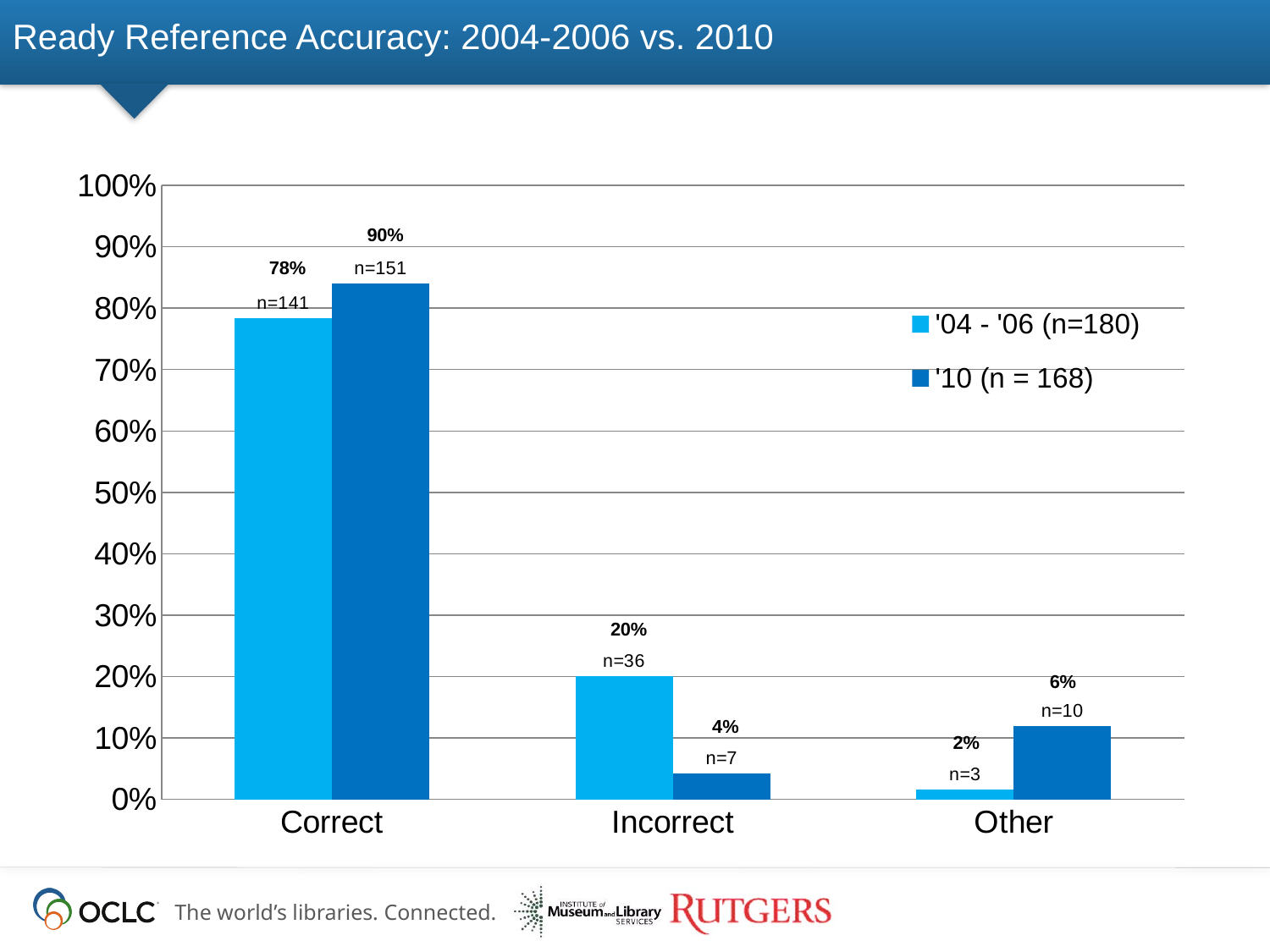
Which category has the highest value for the '10 series? Correct What percentage of ready reference answers were Correct in '10? 90% What is the difference in percentage points between the '10 and '04 - '06 Correct values? 12 What is the sample size (n) given in the legend for the '10 series? 168 What percentage of ready reference answers were Correct in '04 - '06? 78% How many series does the legend list? 2 Which is larger, the Incorrect value for '04 - '06 or for '10? '04 - '06 What kind of chart is shown on the slide? Bar chart What is the n value shown for Incorrect answers in '04 - '06? n=36 What percentage is shown for Other in '10? 6% How many categories are shown on the x axis? 3 Which category has the lowest value for the '04 - '06 series? Other